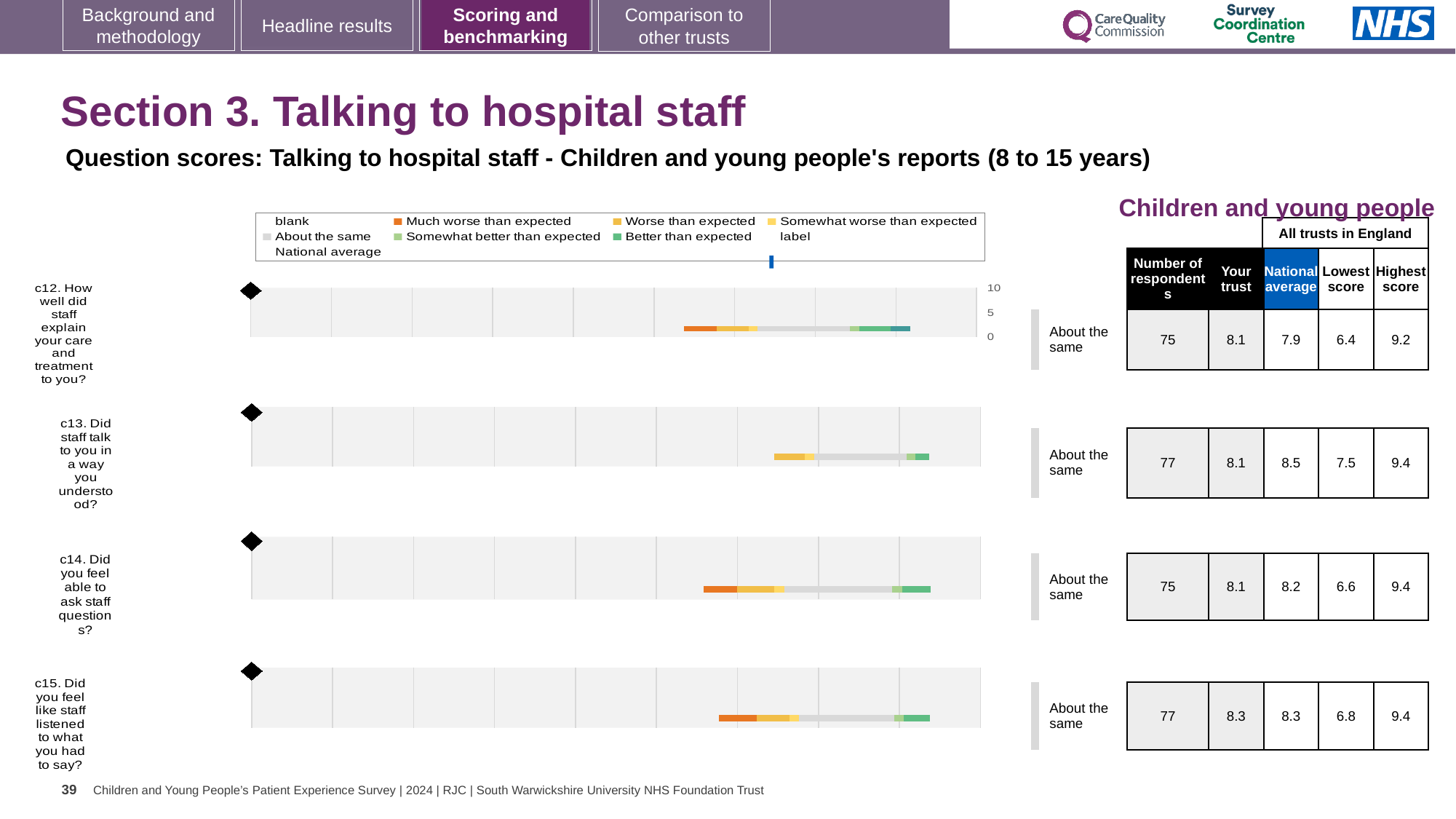
How many question charts (c12 to c15) are shown on the slide? 4 What is the maximum value shown on the score axis of the c12 chart? 10 For the c13 chart (Did staff talk to you in a way you understood?), what is the national average score? 8.5 For the c13 chart, which is larger: the 'Your trust' score or the national average? National average For the c12 chart, what is the difference between the highest score (9.2) and the lowest score (6.4)? 2.8 For the c12 chart (How well did staff explain your care and treatment to you?), what is the 'Your trust' score shown in the table? 8.1 What benchmark label is shown next to the c14 chart? About the same Across the four charts, which question has the highest 'Your trust' score? c15 Across the four charts, which question has the lowest 'Lowest score' value? c12 What kind of chart is used for question c12 on this slide? bar chart For the c15 chart (Did you feel like staff listened to what you had to say?), how many respondents are listed? 77 For the c14 chart (Did you feel able to ask staff questions?), what is the lowest score among all trusts in England? 6.6